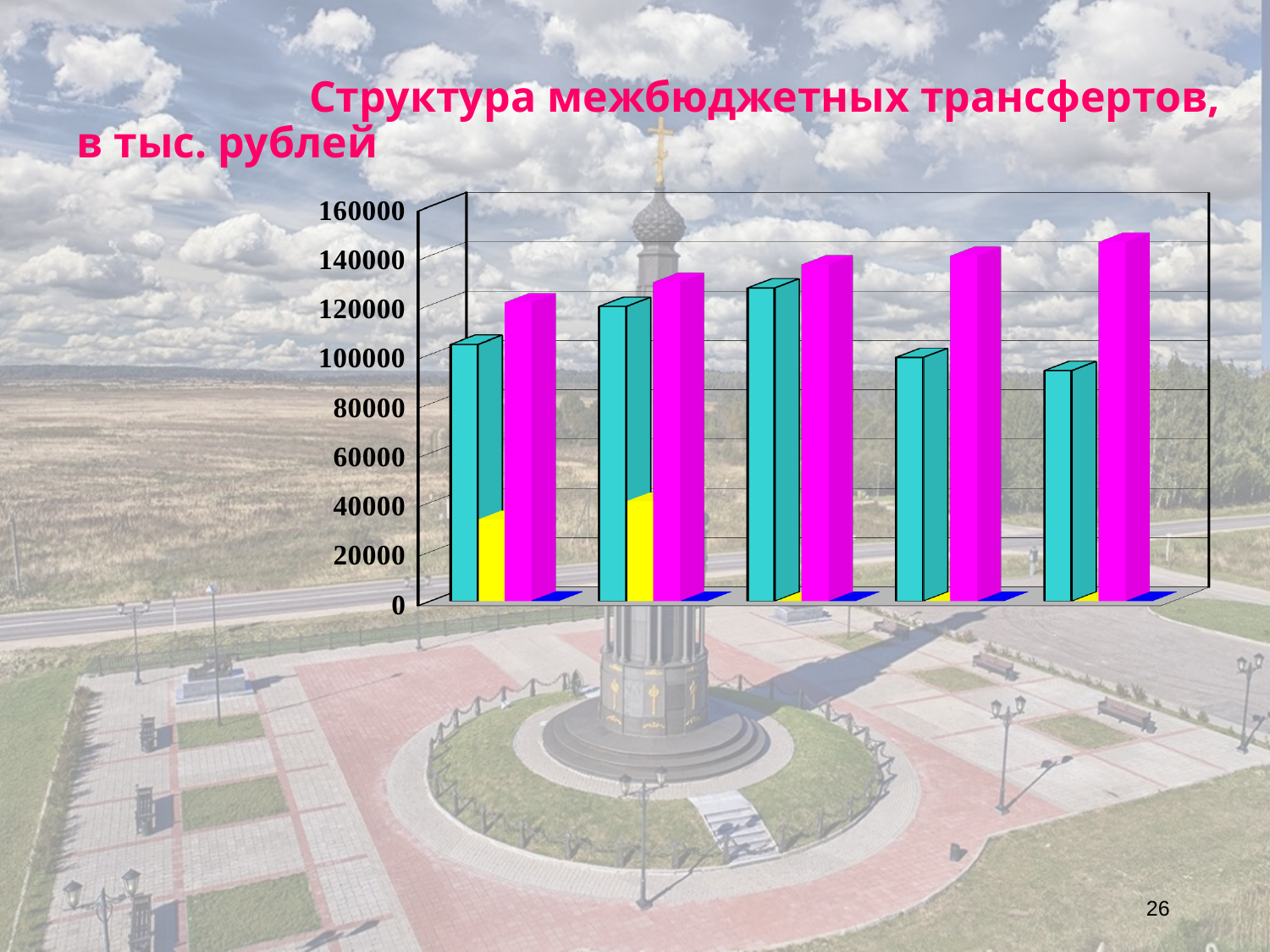
Do the magenta bars rise or fall from left to right across the groups? rise Is the cyan bar in the leftmost group greater or less than 120000? less How many groups of bars are plotted along the x axis? 5 How many differently coloured bars are there in each group? 4 In the rightmost group, which is larger, the magenta bar or the cyan bar? the magenta bar Is the yellow bar in the leftmost group greater or less than 60000? less Is the magenta bar in the rightmost group greater or less than 140000? greater Which group has the tallest magenta bar? the rightmost group Which group has the tallest cyan bar? the third group from the left What kind of chart is shown on the slide? bar chart What is the title of the chart? Структура межбюджетных трансфертов, в тыс. рублей What is the highest value shown on the vertical axis? 160000